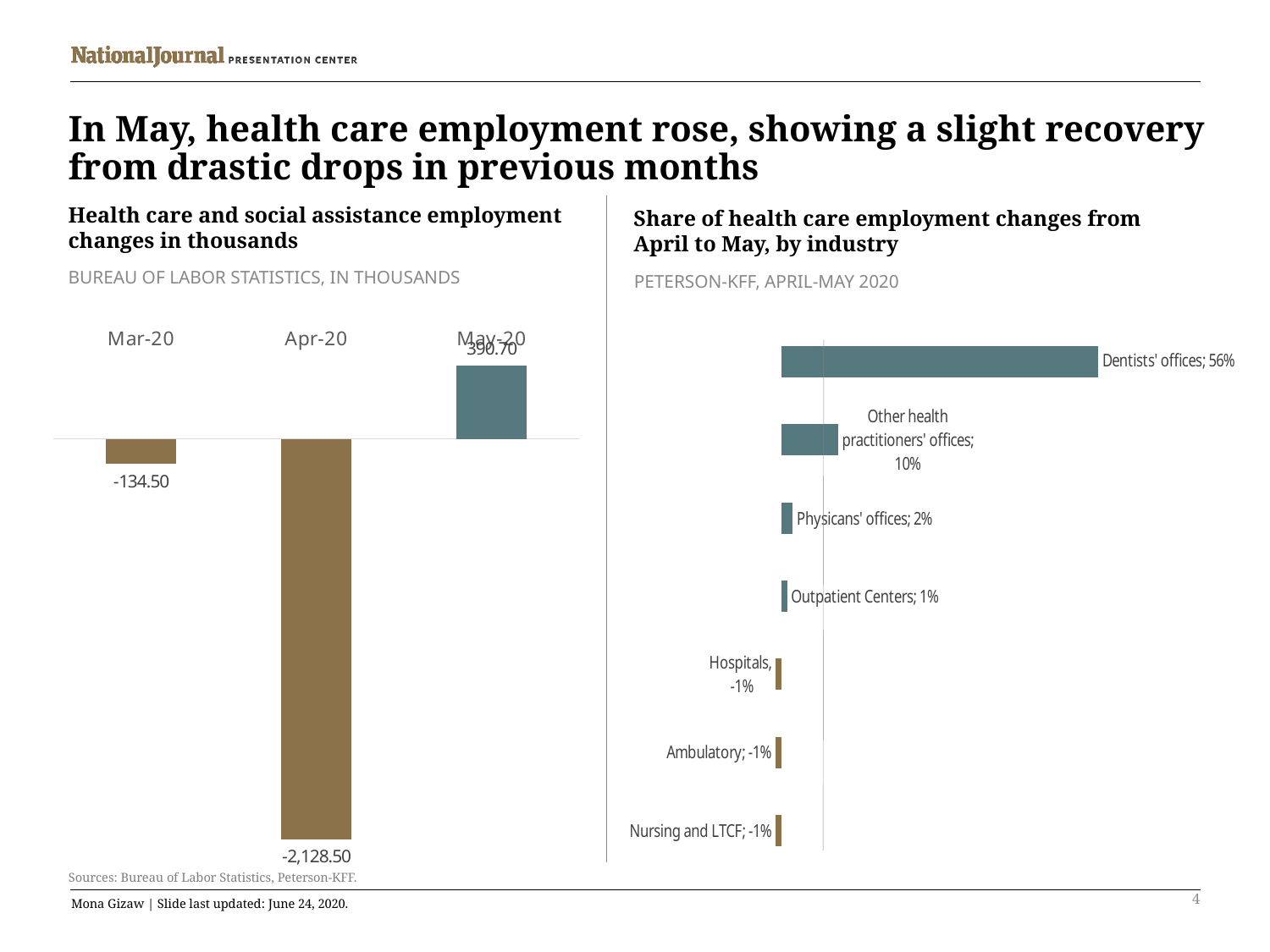
In the right chart, 'Share of health care employment changes from April to May, by industry', what is the share for Dentists' offices? 56% In the left chart, 'Health care and social assistance employment changes in thousands', which month has the lowest value? Apr-20 In the left chart, 'Health care and social assistance employment changes in thousands', how many months are plotted? 3 In the right chart, 'Share of health care employment changes from April to May, by industry', which industry has the highest share? Dentists' offices In the left chart, 'Health care and social assistance employment changes in thousands', what is the value for Apr-20? -2,128.50 In the left chart, 'Health care and social assistance employment changes in thousands', what is the difference between the May-20 and Mar-20 values? 525.20 In the right chart, 'Share of health care employment changes from April to May, by industry', what is the share for Other health practitioners' offices? 10% In the right chart, 'Share of health care employment changes from April to May, by industry', which is larger: the share for Physicans' offices or for Outpatient Centers? Physicans' offices What kind of chart is the right chart, 'Share of health care employment changes from April to May, by industry'? Bar chart In the left chart, 'Health care and social assistance employment changes in thousands', what is the value for May-20? 390.70 In the right chart, 'Share of health care employment changes from April to May, by industry', how many industries are plotted? 7 In the left chart, 'Health care and social assistance employment changes in thousands', what is the value for Mar-20? -134.50